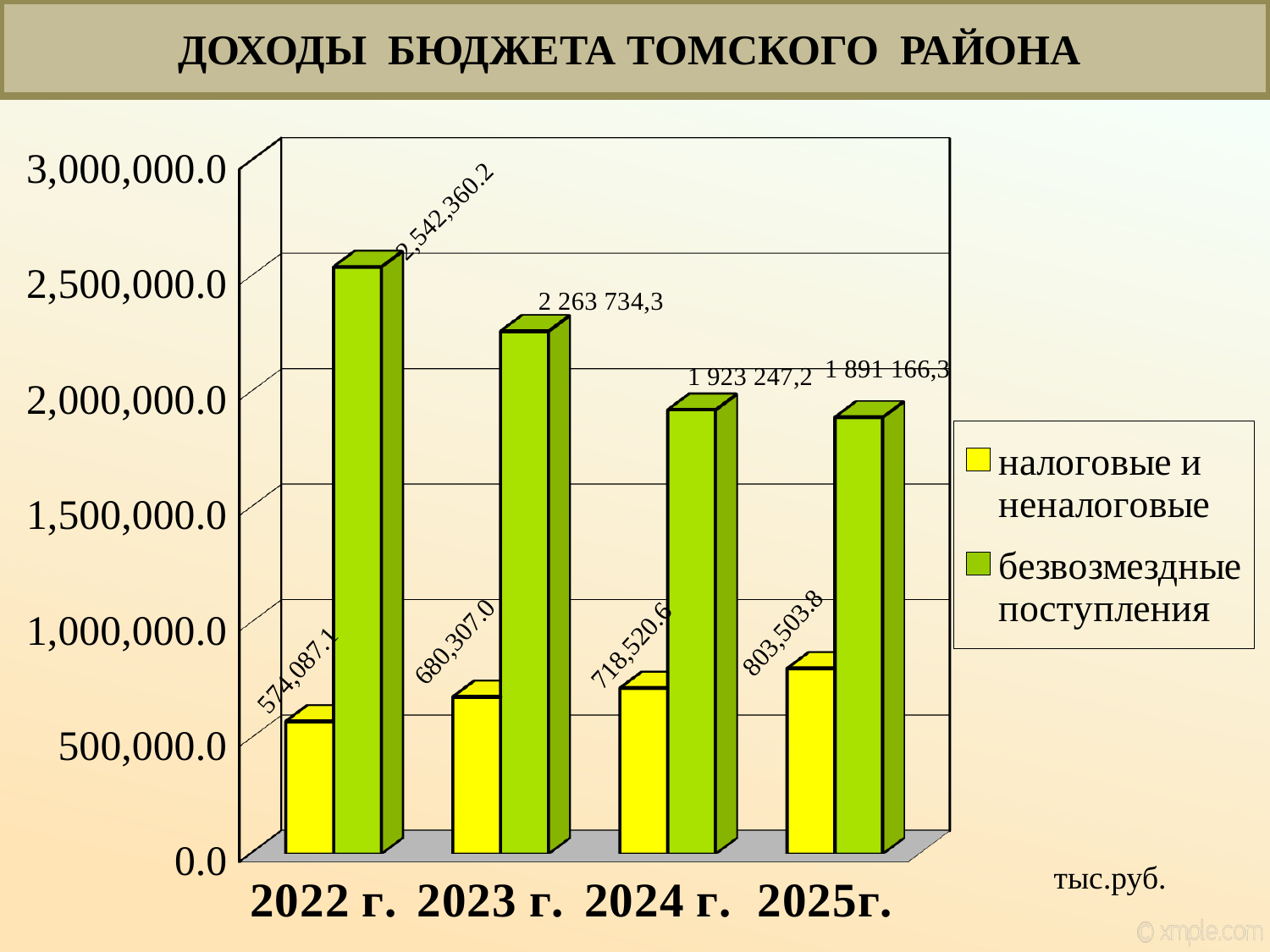
How many series does the legend list? 2 In which year is безвозмездные поступления highest? 2022 г. What is the title of the chart? ДОХОДЫ БЮДЖЕТА ТОМСКОГО РАЙОНА What type of chart is shown on the slide? bar chart Is the value of безвозмездные поступления for 2025г. greater or less than 2,000,000.0? less What is the value of налоговые и неналоговые for 2022 г.? 574,087.1 Which is larger in 2024 г.: налоговые и неналоговые or безвозмездные поступления? безвозмездные поступления Do the values of безвозмездные поступления rise or fall from 2022 г. to 2025г.? fall What is the value of налоговые и неналоговые for 2025г.? 803,503.8 How many years are shown on the x axis? 4 What is the value of безвозмездные поступления for 2023 г.? 2 263 734,3 In which year is налоговые и неналоговые lowest? 2022 г.